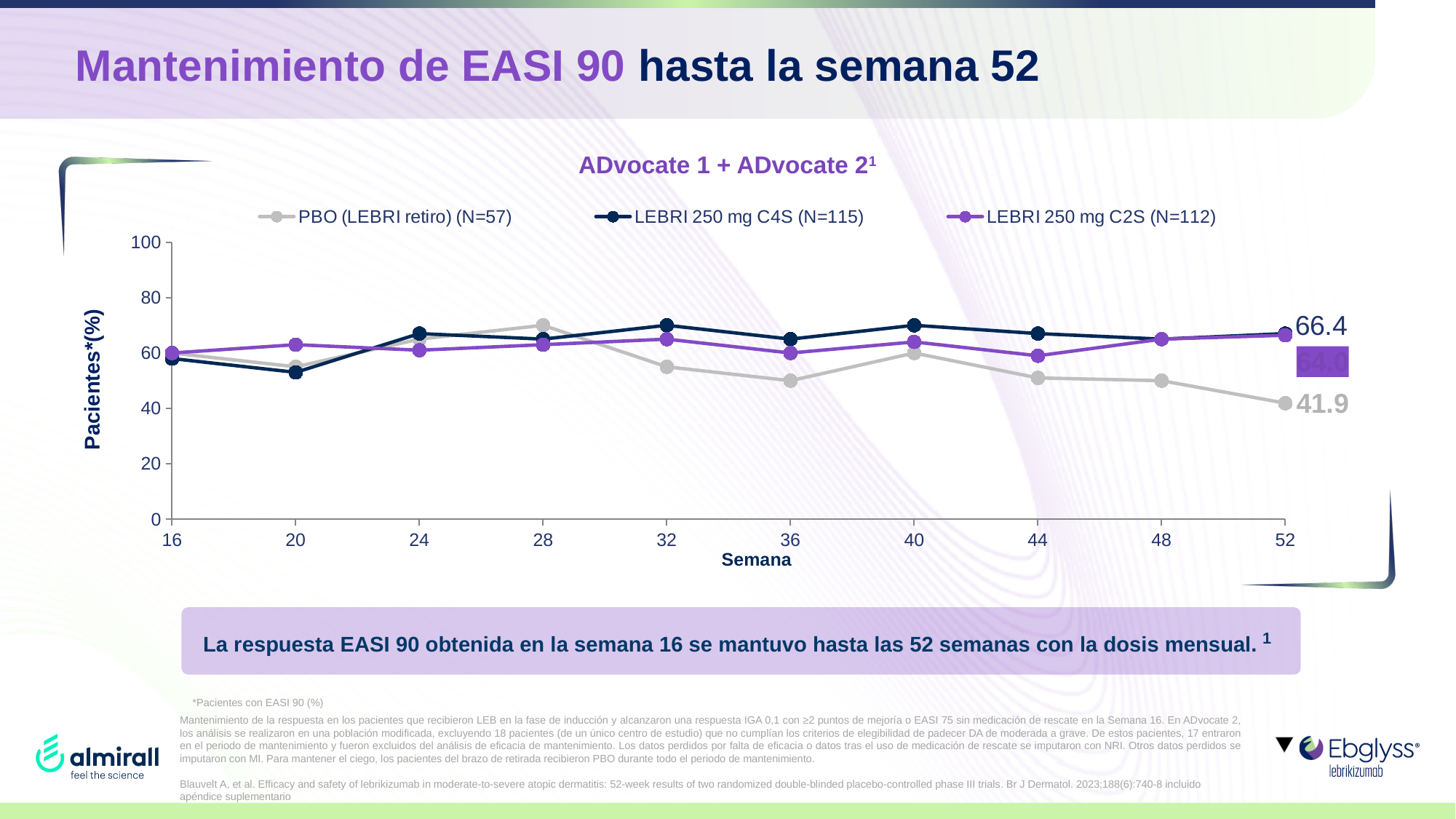
Which series has the lowest value at week 52? PBO (LEBRI retiro) (N=57) What kind of chart is shown on the slide? Line chart What is the difference between the LEBRI 250 mg C4S and PBO values at week 52? 24.5 Which series has the highest value at week 52? LEBRI 250 mg C4S (N=115) What is the value for LEBRI 250 mg C2S (N=112) at week 52? 64.0 Is the value for PBO (LEBRI retiro) at week 36 greater or less than 60? less What is the value for PBO (LEBRI retiro) (N=57) at week 52? 41.9 What is the value for LEBRI 250 mg C4S (N=115) at week 52? 66.4 What is the label of the x axis? Semana How many series does the legend list? 3 Does the PBO (LEBRI retiro) line rise or fall from week 40 to week 52? Fall How many week time points are marked on the x axis? 10